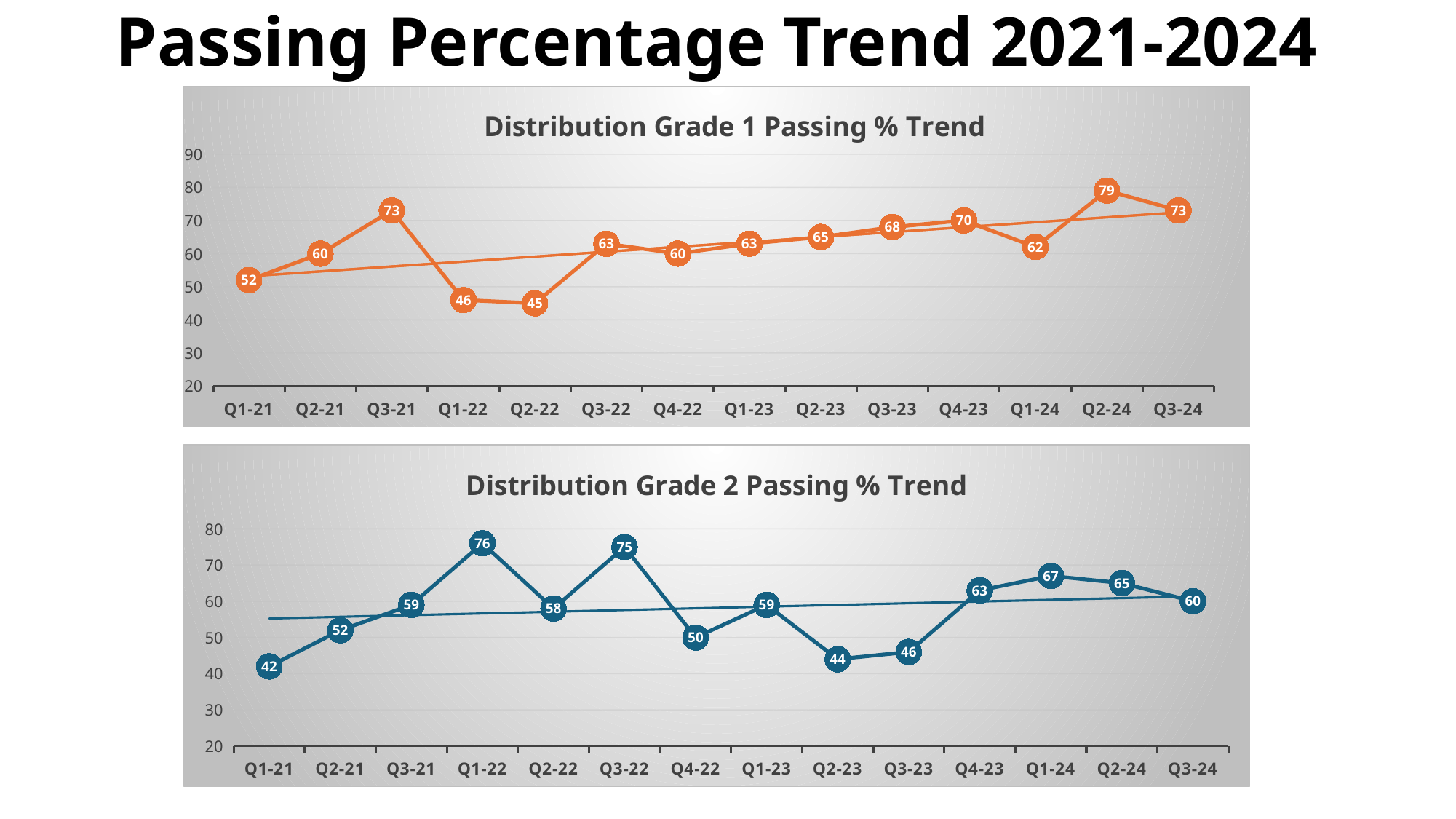
In the Distribution Grade 2 Passing % Trend chart, which quarter has the lowest value? Q1-21 In the Distribution Grade 2 Passing % Trend chart, what is the value for Q2-23? 44 In the Distribution Grade 2 Passing % Trend chart, which quarter has the highest value? Q1-22 In the Distribution Grade 1 Passing % Trend chart, what is the difference between the values for Q2-24 and Q1-24? 17 In the Distribution Grade 1 Passing % Trend chart, what is the value for Q3-21? 73 In the Distribution Grade 2 Passing % Trend chart, do the values rise or fall from Q1-21 to Q3-21? Rise In the Distribution Grade 2 Passing % Trend chart, what is the difference between the values for Q1-22 and Q2-22? 18 In the Distribution Grade 1 Passing % Trend chart, which quarter has the lowest value? Q2-22 What type of chart is the Distribution Grade 1 Passing % Trend chart? Line chart In the Distribution Grade 2 Passing % Trend chart, which is larger, the value for Q1-24 or the value for Q3-24? Q1-24 In the Distribution Grade 1 Passing % Trend chart, how many quarters are plotted? 14 In the Distribution Grade 1 Passing % Trend chart, which quarter has the highest value? Q2-24